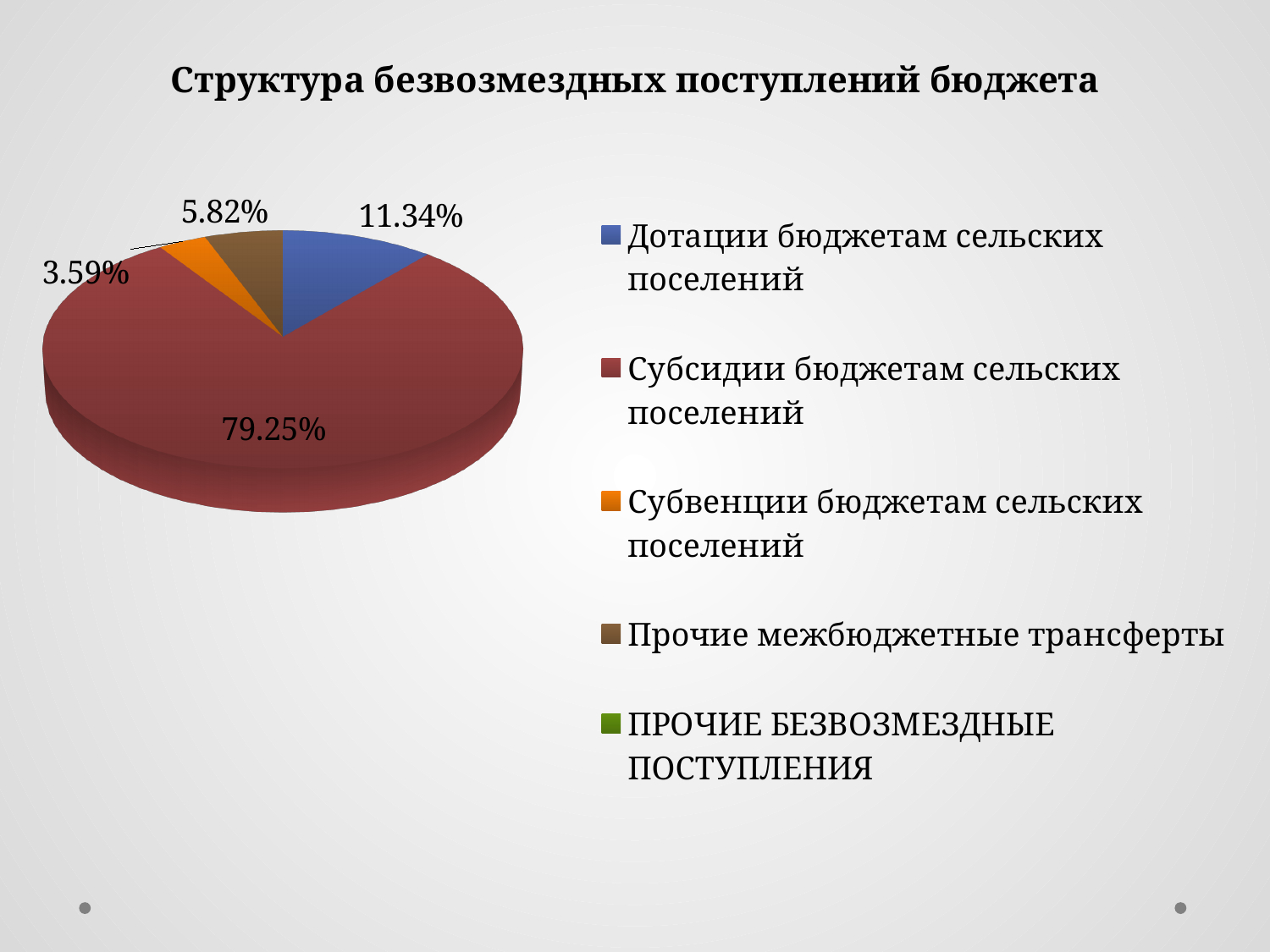
What is the difference in percentage points between the shares for Дотации бюджетам сельских поселений and Прочие межбюджетные трансферты? 5.52 What share of the pie is Прочие межбюджетные трансферты? 5.82% What colour is the slice for Субвенции бюджетам сельских поселений? orange Which of the labelled slices has the smallest share? Субвенции бюджетам сельских поселений How many entries does the legend list? 5 What share of the pie is Дотации бюджетам сельских поселений? 11.34% What share of the pie is Субсидии бюджетам сельских поселений? 79.25% What share of the pie is Субвенции бюджетам сельских поселений? 3.59% Which is larger: the share for Дотации бюджетам сельских поселений or for Прочие межбюджетные трансферты? Дотации бюджетам сельских поселений Which category has the largest share of the pie? Субсидии бюджетам сельских поселений What is the title of the chart? Структура безвозмездных поступлений бюджета What kind of chart is shown on the slide? pie chart